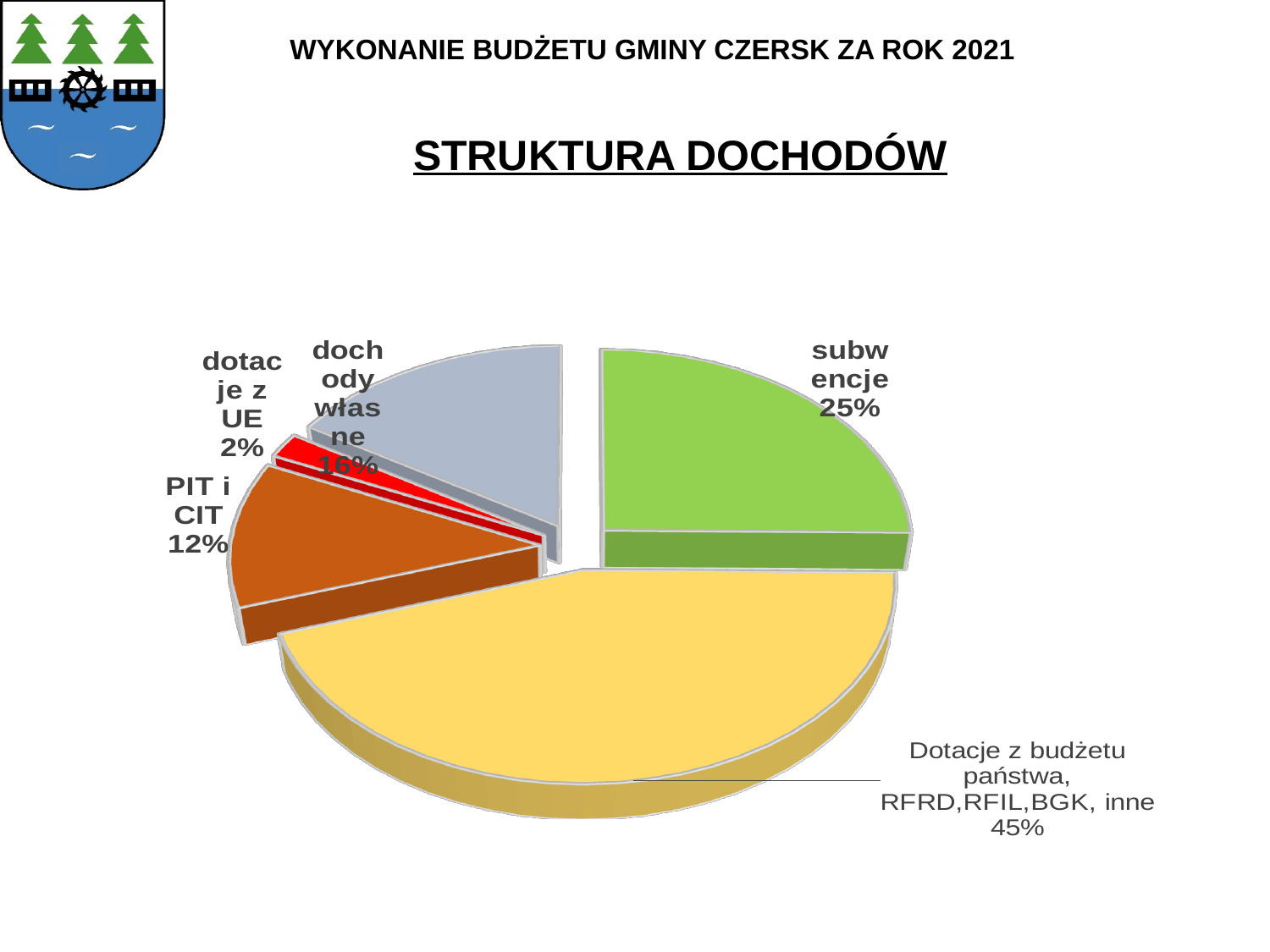
What is the difference in percentage points between 'subwencje' and 'PIT i CIT'? 13 What kind of chart is shown on the slide? pie chart What share of the pie does 'subwencje' have? 25% How many slices does the pie chart have? 5 What share of the pie does 'Dotacje z budżetu państwa, RFRD,RFIL,BGK, inne' have? 45% What share of the pie does 'dochody własne' have? 16% Which is larger, the share for 'dochody własne' or the share for 'PIT i CIT'? dochody własne What is the title of the chart? STRUKTURA DOCHODÓW Which category has the smallest slice of the pie? dotacje z UE Which category has the largest slice of the pie? Dotacje z budżetu państwa, RFRD,RFIL,BGK, inne